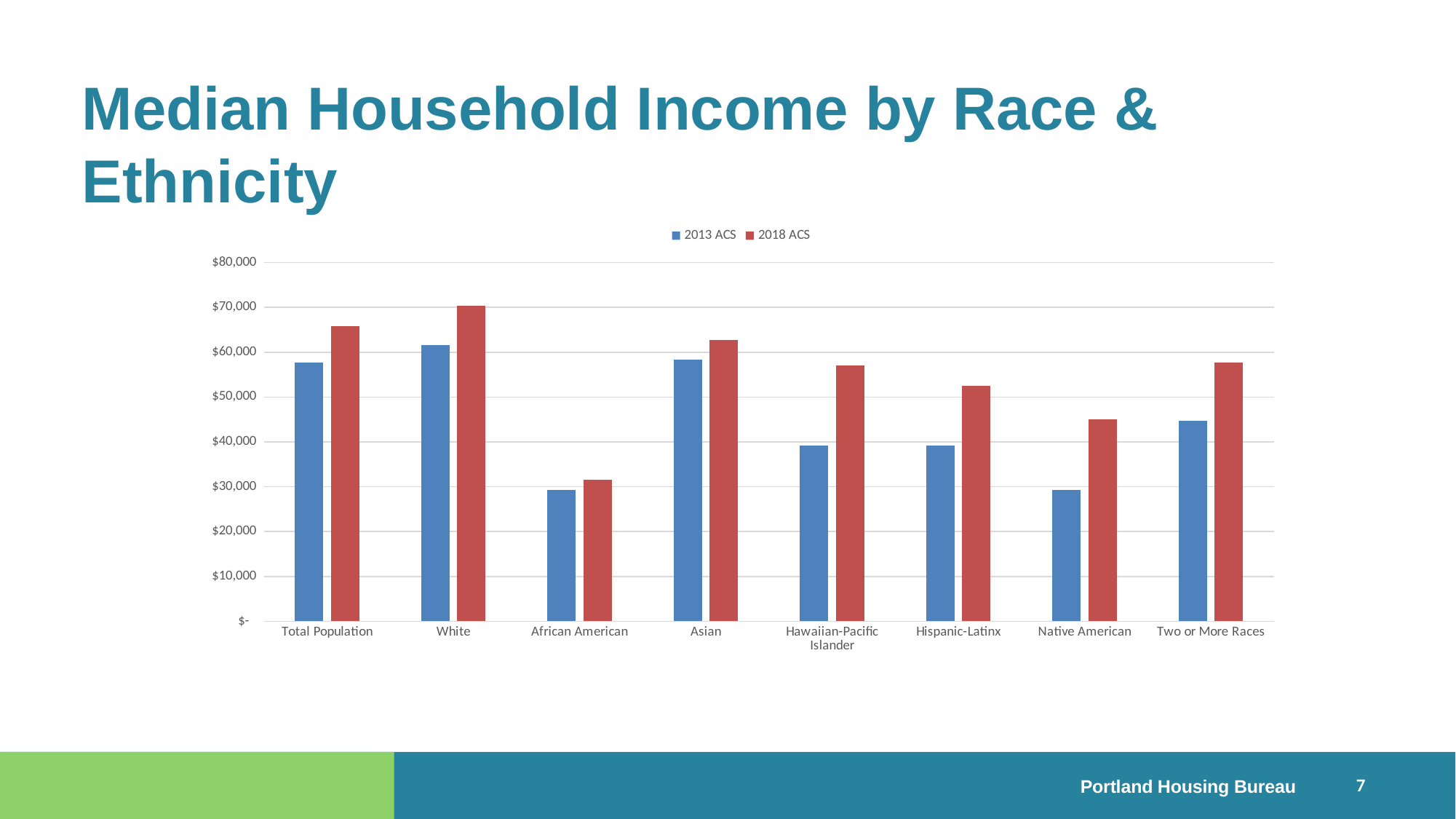
What kind of chart is shown on the slide? bar chart How many series does the legend list? 2 Is the 2018 ACS value for White greater or less than $60,000? greater Which category has the highest 2013 ACS median household income? White How many race/ethnicity categories are shown on the x axis? 8 Which series is shown in red in the legend? 2018 ACS Is the 2013 ACS value for Native American greater or less than $40,000? less Which category has the lowest 2018 ACS median household income? African American Is the 2013 ACS value for Two or More Races greater or less than $50,000? less Which is larger: the 2018 ACS value for White or the 2018 ACS value for Asian? White Which category has the highest 2018 ACS median household income? White